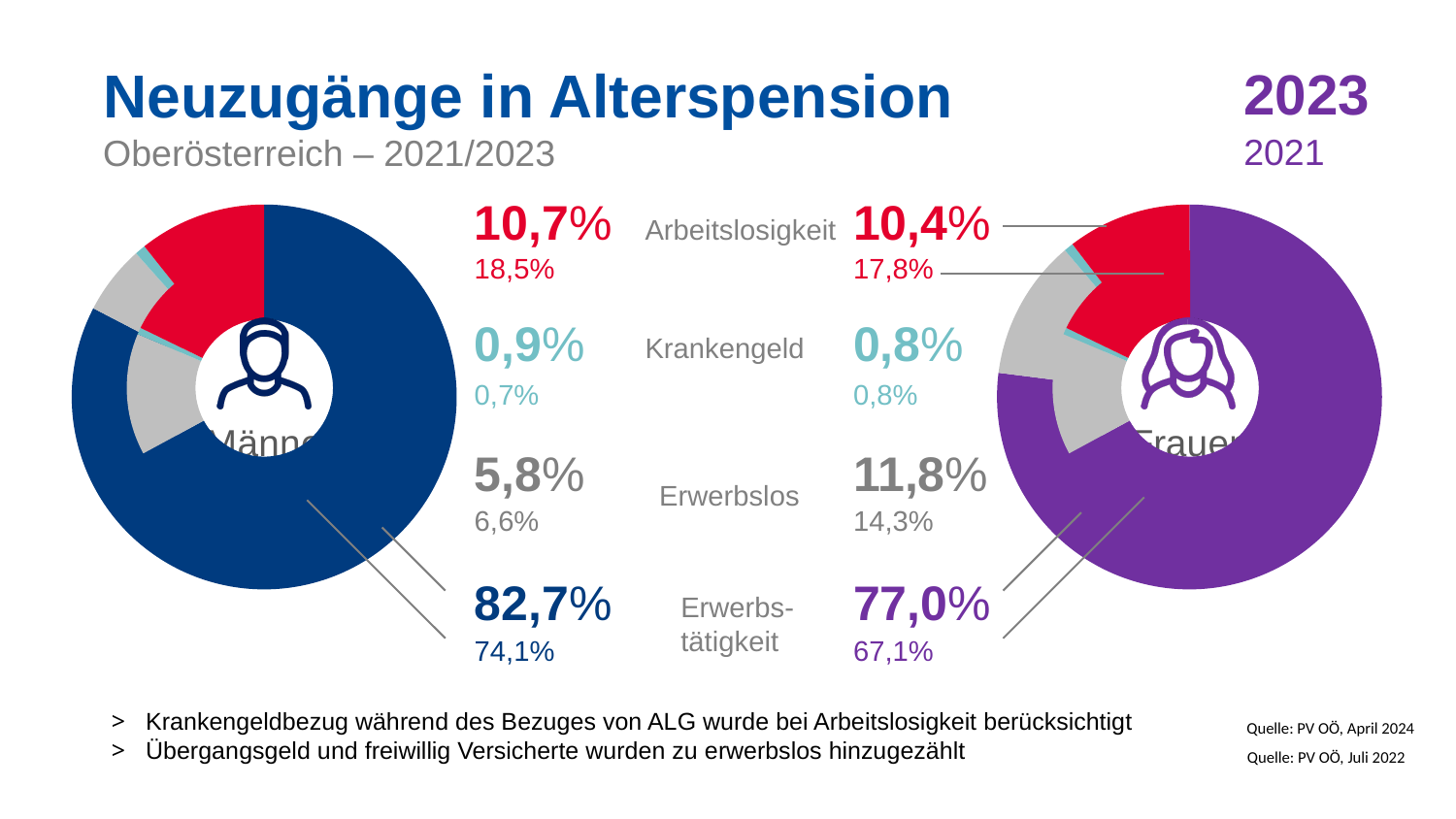
Is the 2023 Erwerbslos share larger for Männer or for Frauen? Frauen On the Frauen chart, what was the 2021 share for Erwerbstätigkeit? 67,1% On the Männer chart, what was the 2021 share for Arbeitslosigkeit? 18,5% What kind of chart is used to show the Männer and Frauen data? Donut (pie) chart On the Männer chart, which category has the smallest 2023 share? Krankengeld On the Männer chart, what is the 2023 share for Erwerbstätigkeit? 82,7% On the Frauen chart, what is the 2023 share for Erwerbslos? 11,8% How many categories are shown for each donut chart? 4 Did the Arbeitslosigkeit share for Männer rise or fall from 2021 to 2023? Fall On the Frauen chart, which category has the largest 2023 share? Erwerbstätigkeit What is the difference between the 2023 Erwerbstätigkeit shares for Männer and Frauen? 5,7 percentage points Which two years are compared on the slide? 2023 and 2021